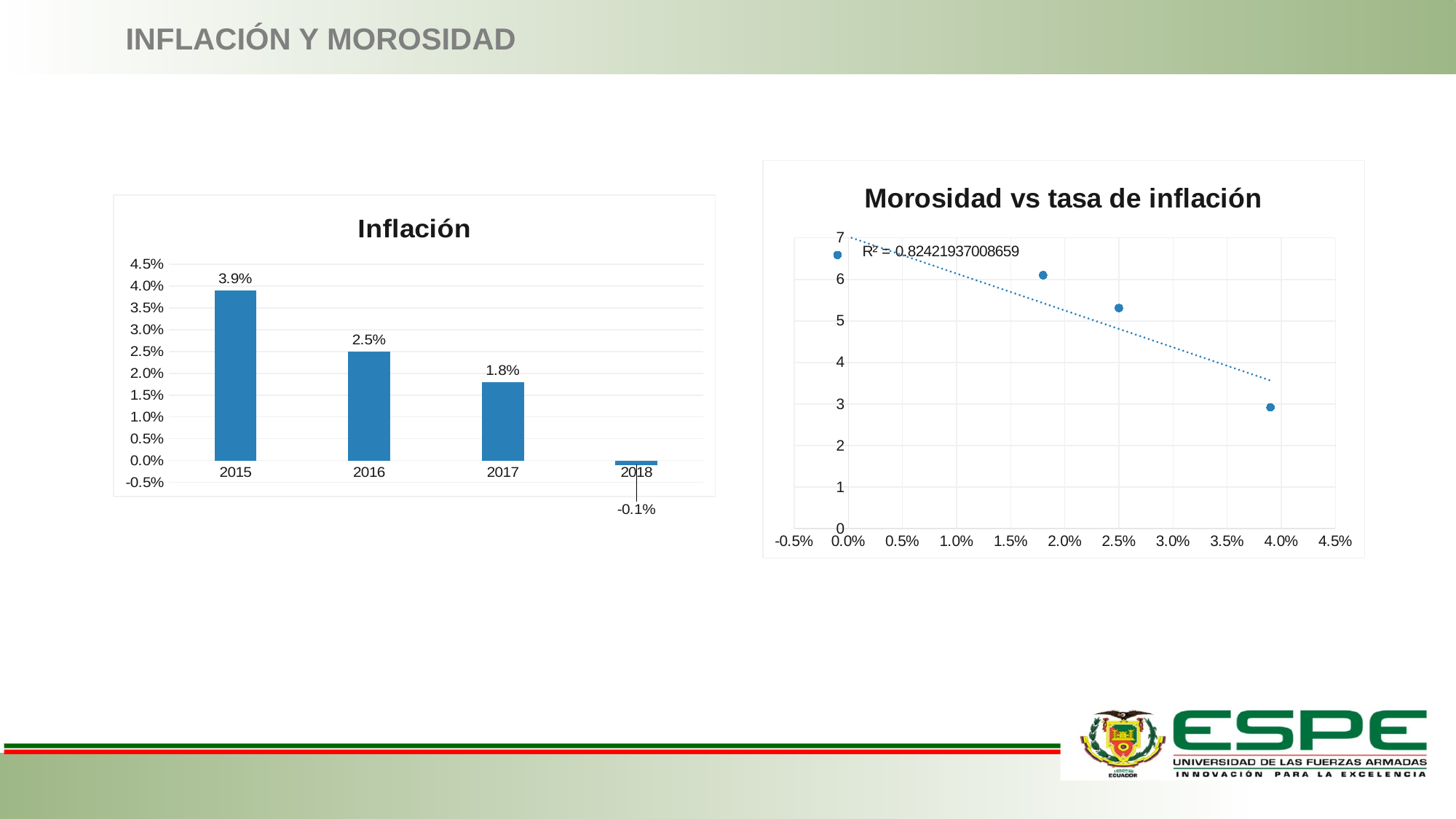
In the 'Inflación' chart, what is the difference between the inflation values for 2015 and 2016? 1.4% In the 'Inflación' chart, which year has a larger inflation value, 2016 or 2017? 2016 In the 'Inflación' chart, which year has the lowest inflation? 2018 In the 'Morosidad vs tasa de inflación' chart, how many data points are plotted? 4 In the 'Inflación' chart, what is the inflation value for 2018? -0.1% In the 'Inflación' chart, how many years are shown? 4 In the 'Inflación' chart, which year has the highest inflation? 2015 In the 'Morosidad vs tasa de inflación' chart, what R² value is shown? 0.82421937008659 In the 'Inflación' chart, do the values rise or fall from 2015 to 2018? fall In the 'Inflación' chart, what is the inflation value for 2017? 1.8% What kind of chart is the 'Morosidad vs tasa de inflación' chart? scatter chart In the 'Inflación' chart, what is the inflation value for 2015? 3.9%